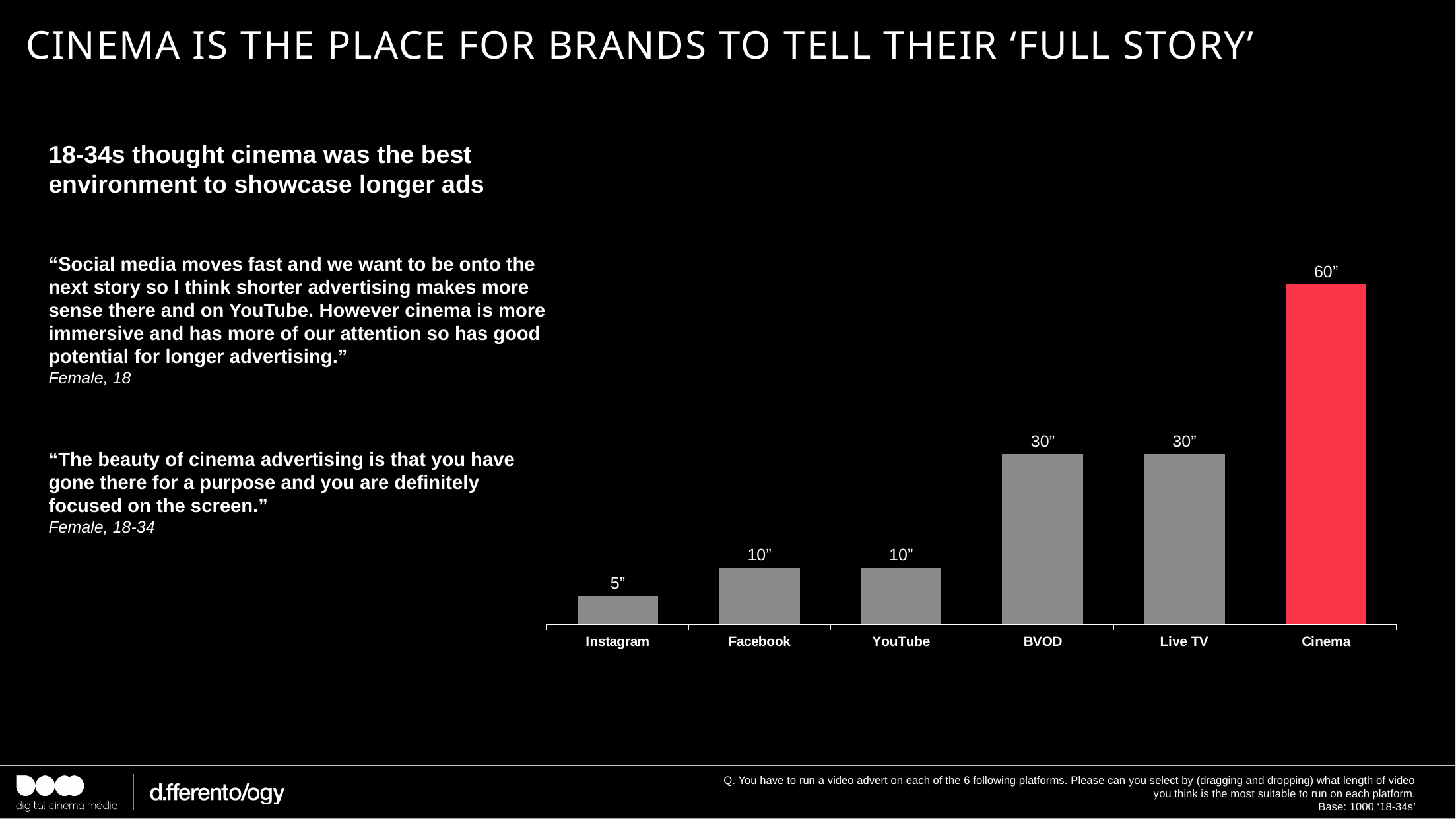
How many platforms are shown on the chart? 6 Which bar on the chart is coloured red rather than grey? Cinema What is the difference between the values for Cinema and Live TV? 30” Which has a larger value, BVOD or Facebook? BVOD What is the value shown for Cinema? 60” Which platform has the lowest value? Instagram Which platform has the highest value? Cinema What is the value shown for Instagram? 5” What is the value shown for Facebook? 10” What is the value shown for BVOD? 30” What is the difference between the values for YouTube and Instagram? 5” What kind of chart is shown on the slide? Bar chart